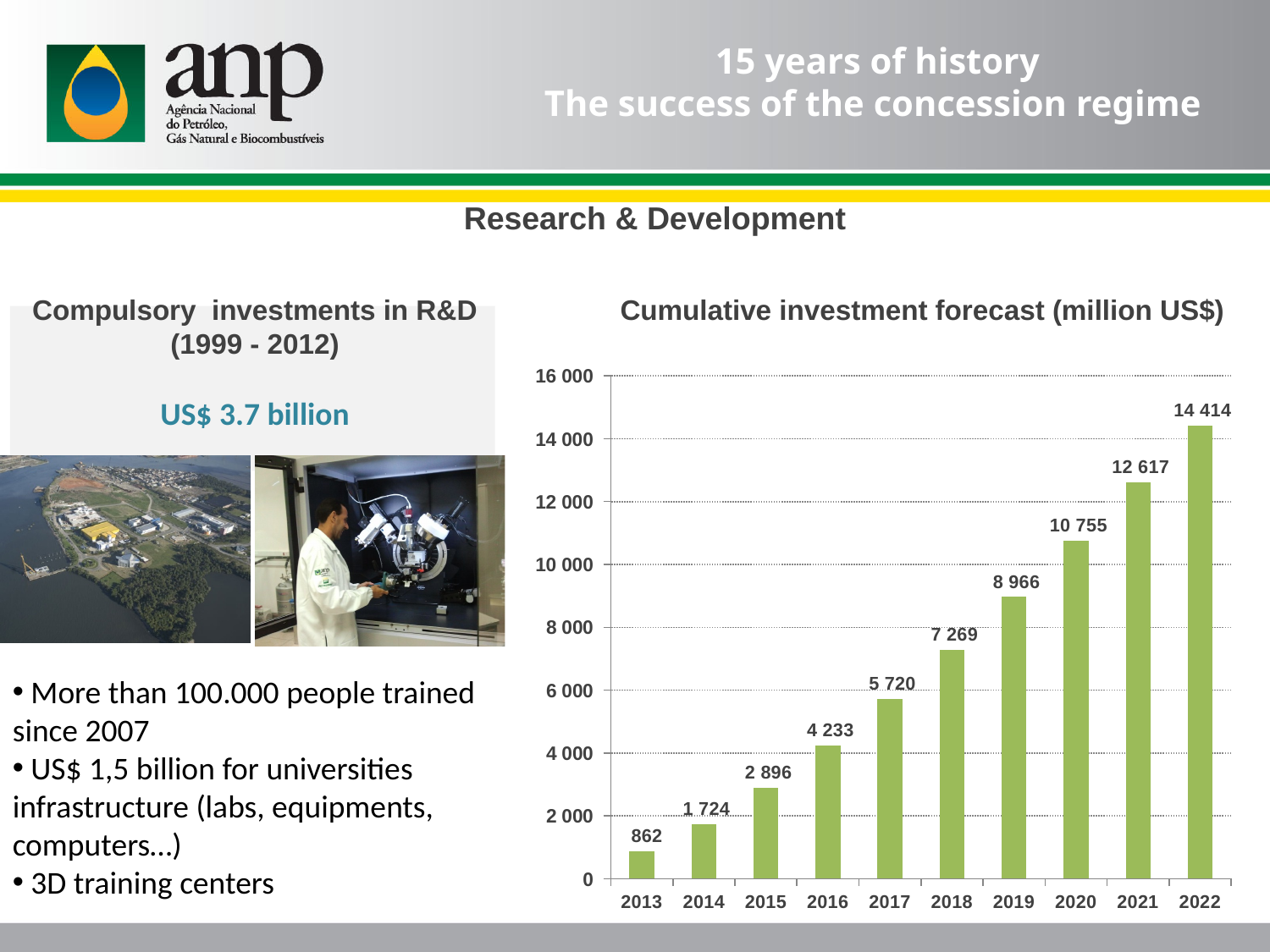
Which year has the highest cumulative investment forecast? 2022 What is the cumulative investment forecast for 2013? 862 How many years are shown on the x axis of the chart? 10 Is the cumulative investment forecast for 2020 greater or less than 10 000? greater What is the cumulative investment forecast for 2022? 14 414 What is the difference between the cumulative investment forecast for 2017 and 2016? 1 487 Which year has the lowest cumulative investment forecast? 2013 Which is larger, the cumulative investment forecast for 2019 or for 2020? 2020 Do the cumulative investment forecast values rise or fall from 2013 to 2022? Rise What is the cumulative investment forecast for 2018? 7 269 What kind of chart is used to show the cumulative investment forecast? Bar chart What is the difference between the cumulative investment forecast for 2022 and 2021? 1 797